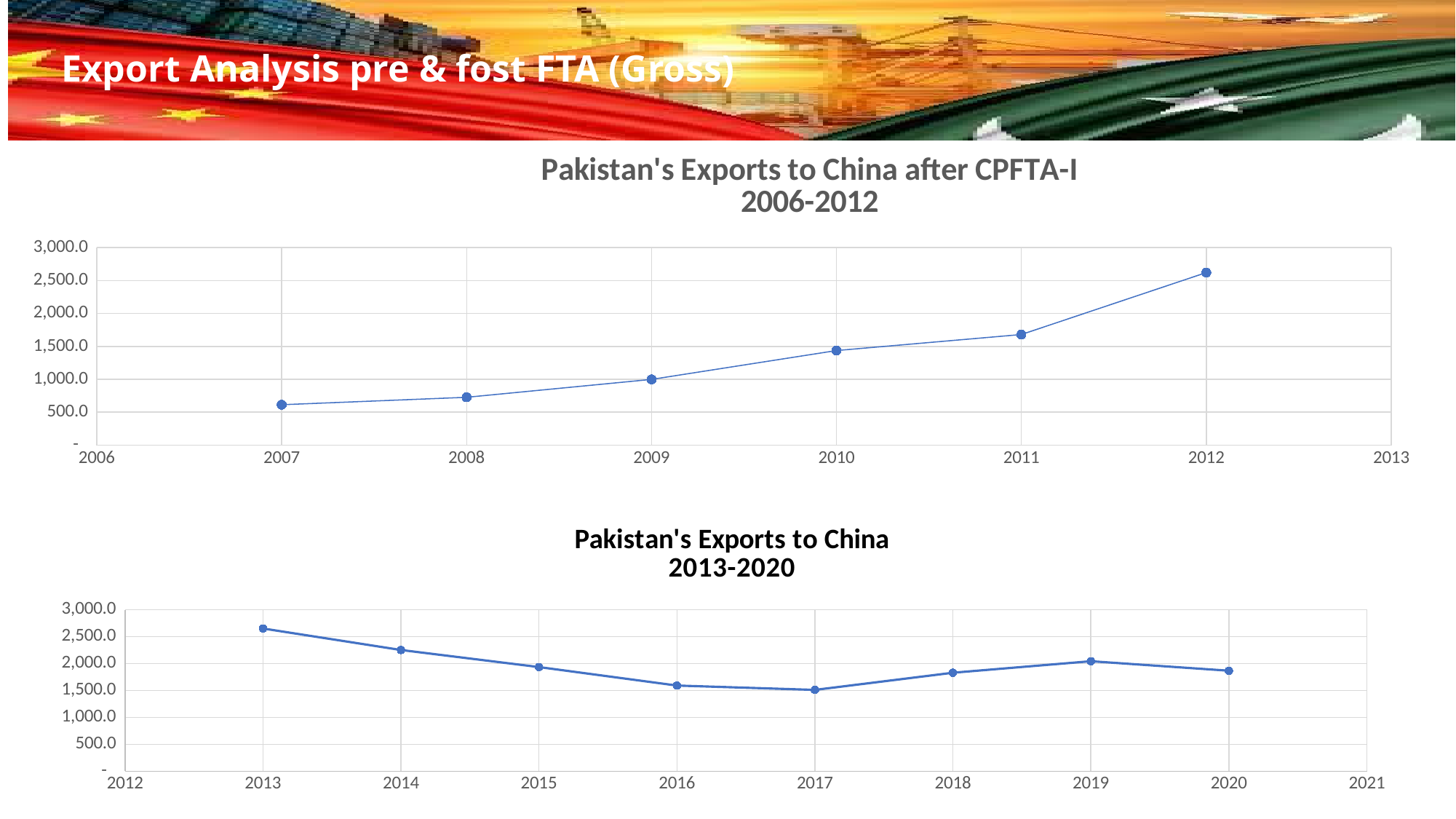
In the top chart (2006-2012), which year has the lowest value? 2007 In the bottom chart (2013-2020), which is larger, the value for 2014 or the value for 2019? 2014 In the top chart (2006-2012), is the value for 2012 greater or less than 2,500.0? greater In the bottom chart (2013-2020), which year has the highest value? 2013 In the top chart (2006-2012), do the values rise or fall from 2007 to 2012? Rise What kind of chart is "Pakistan's Exports to China after CPFTA-I 2006-2012"? Line chart In the top chart (2006-2012), how many data points are plotted? 6 In the bottom chart (2013-2020), which year has the lowest value? 2017 In the bottom chart (2013-2020), is the value for 2019 greater or less than 1,500.0? greater In the bottom chart (2013-2020), how many data points are plotted? 8 In the top chart (2006-2012), which year has the highest value? 2012 In the top chart (2006-2012), is the value for 2008 greater or less than 1,000.0? less